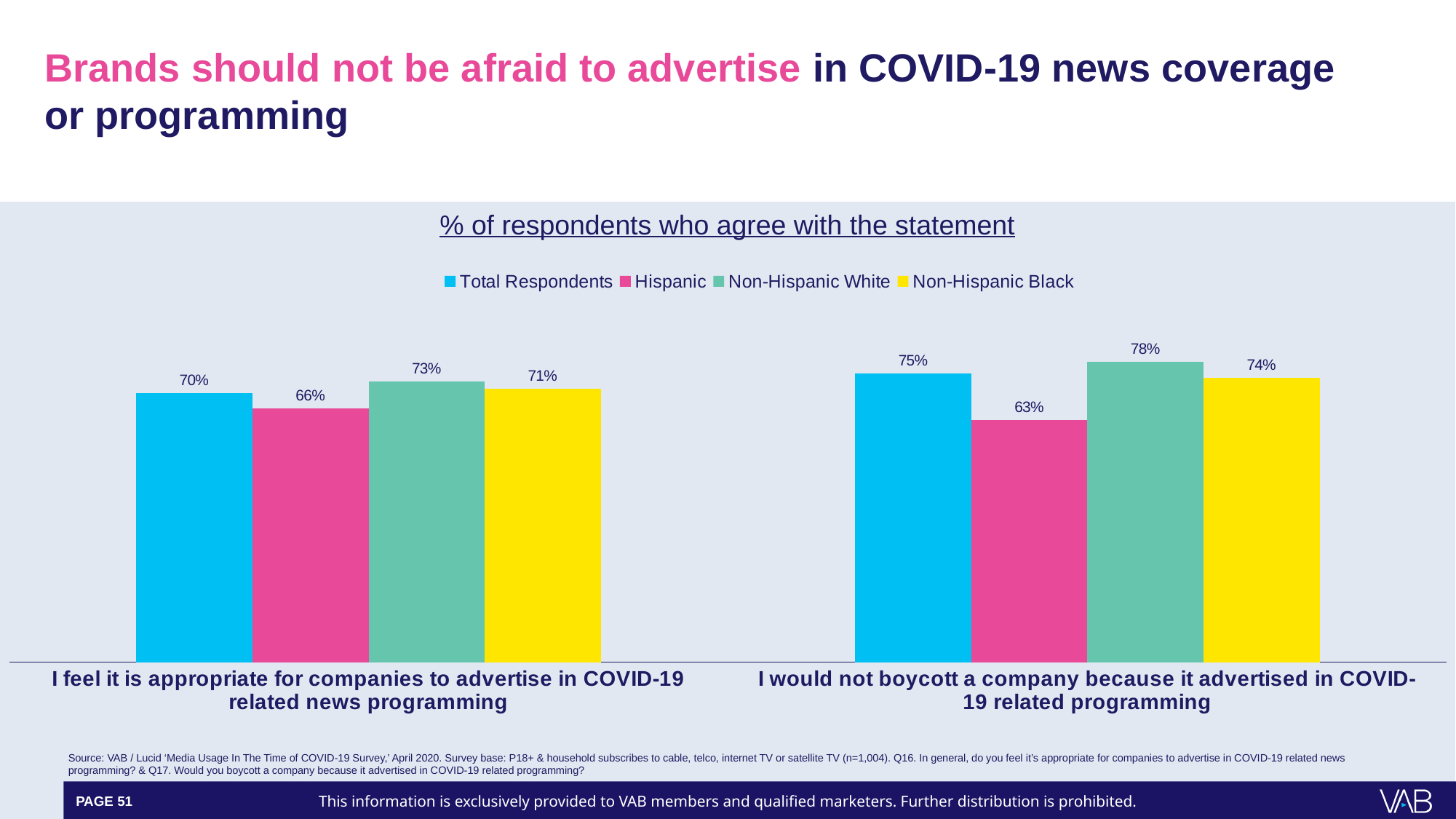
Which colour represents Non-Hispanic Black in the chart? Yellow Which is larger: Non-Hispanic Black agreement on the 'appropriate to advertise' statement or Total Respondents agreement on the same statement? Non-Hispanic Black What percentage of Hispanic respondents agree that it is appropriate for companies to advertise in COVID-19 related news programming? 66% How many statements (categories) are shown on the x axis? 2 How many series does the legend list? 4 What kind of chart is shown on the slide? Bar chart What is the title of the chart? % of respondents who agree with the statement What is the difference between Non-Hispanic White and Hispanic agreement on the 'I would not boycott a company' statement? 15 percentage points Which group has the lowest agreement with 'I would not boycott a company because it advertised in COVID-19 related programming'? Hispanic Which group has the highest agreement with 'I feel it is appropriate for companies to advertise in COVID-19 related news programming'? Non-Hispanic White What percentage of Non-Hispanic White respondents agree they would not boycott a company because it advertised in COVID-19 related programming? 78% What is the value for Total Respondents on the statement 'I would not boycott a company because it advertised in COVID-19 related programming'? 75%